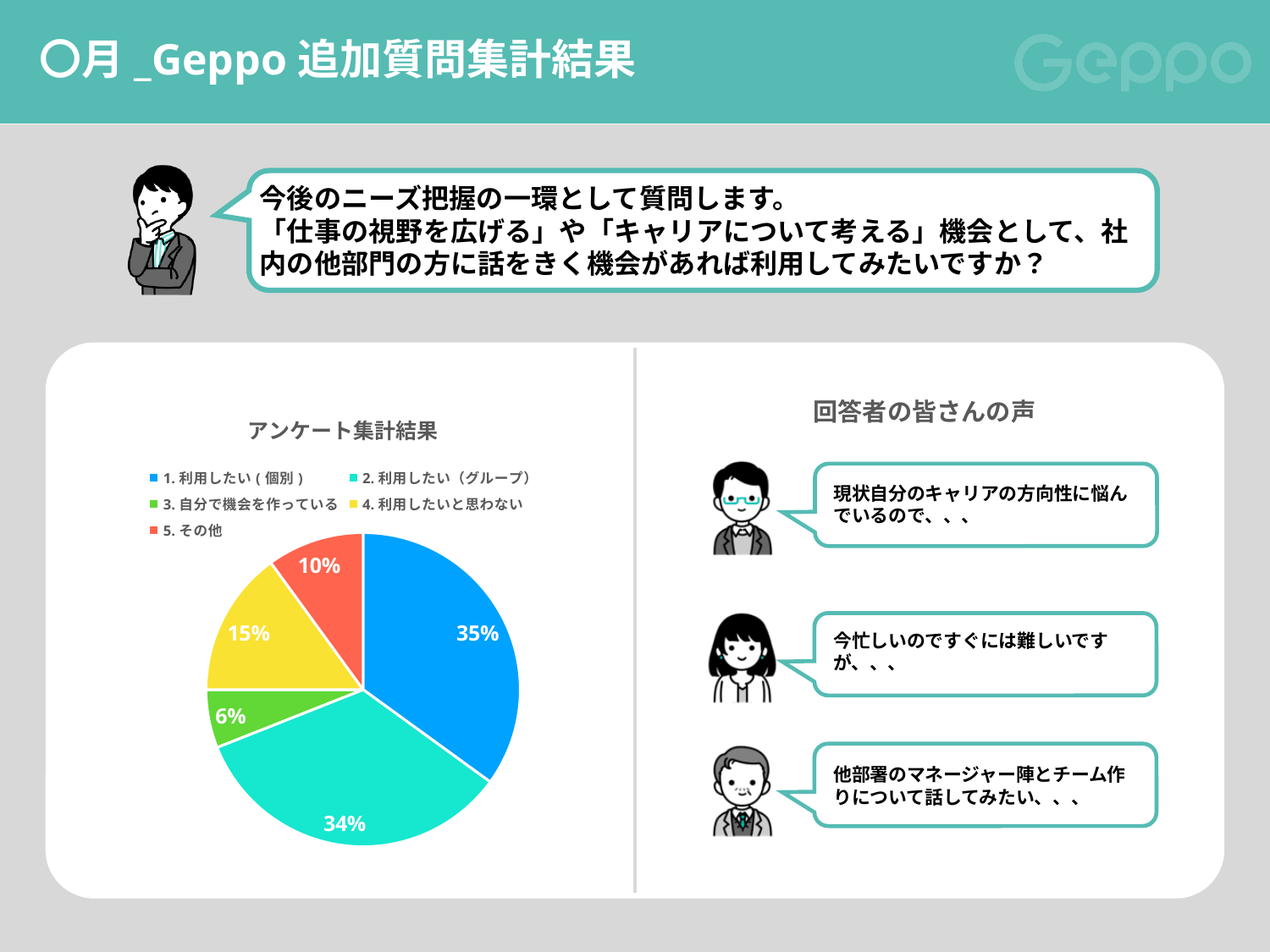
In the pie chart アンケート集計結果, what share is shown for 2. 利用したい（グループ）? 34% In the pie chart アンケート集計結果, which category has the largest share? 1. 利用したい(個別) What kind of chart is shown under the title アンケート集計結果? pie chart In the pie chart アンケート集計結果, which is larger: the share for 4. 利用したいと思わない or the share for 3. 自分で機会を作っている? 4. 利用したいと思わない In the pie chart アンケート集計結果, what colour is the slice for 5. その他? red In the pie chart アンケート集計結果, what share is shown for 1. 利用したい(個別)? 35% In the pie chart アンケート集計結果, what share is shown for 5. その他? 10% In the pie chart アンケート集計結果, what share is shown for 3. 自分で機会を作っている? 6% In the pie chart アンケート集計結果, what is the difference in percentage points between 4. 利用したいと思わない and 5. その他? 5 In the pie chart アンケート集計結果, what share is shown for 4. 利用したいと思わない? 15% In the pie chart アンケート集計結果, which category has the smallest share? 3. 自分で機会を作っている In the pie chart アンケート集計結果, how many categories does the legend list? 5